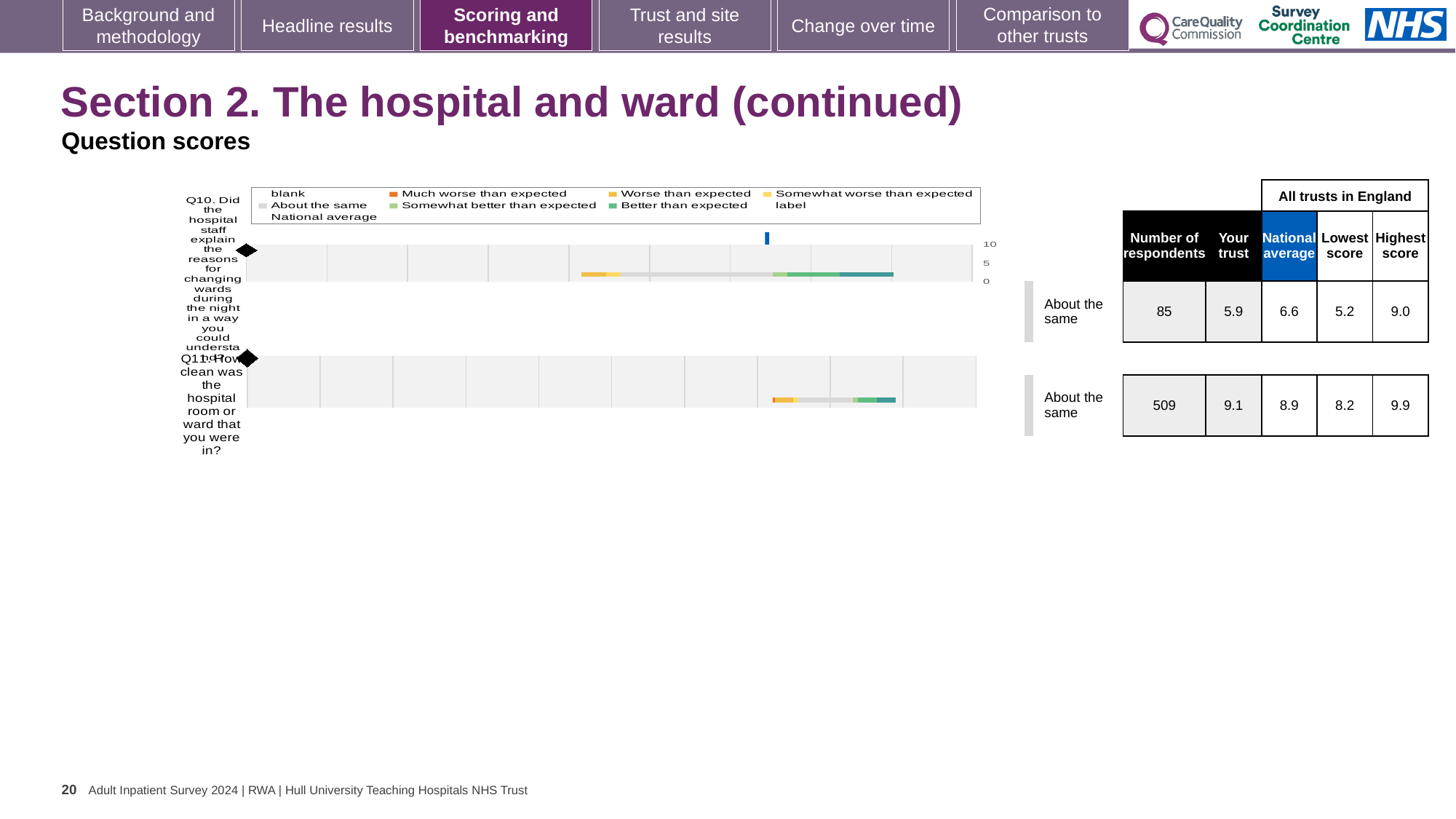
What benchmark category is shown for Q10? About the same For Q10, which is higher: the trust's score or the national average? National average How many respondents answered Q10 (Did the hospital staff explain the reasons for changing wards during the night)? 85 Which question had more respondents, Q10 or Q11? Q11 How many questions are charted on this slide? 2 What is the highest score among all trusts in England for Q11? 9.9 What is the difference between the highest and lowest scores for Q10? 3.8 What is the national average score for Q11? 8.9 By how much does the trust's score for Q11 exceed the national average? 0.2 What is the lowest score among all trusts in England for Q10? 5.2 What kind of chart is used to show the question scores? Bar chart What is the 'Your trust' score for Q11 (How clean was the hospital room or ward that you were in?)? 9.1